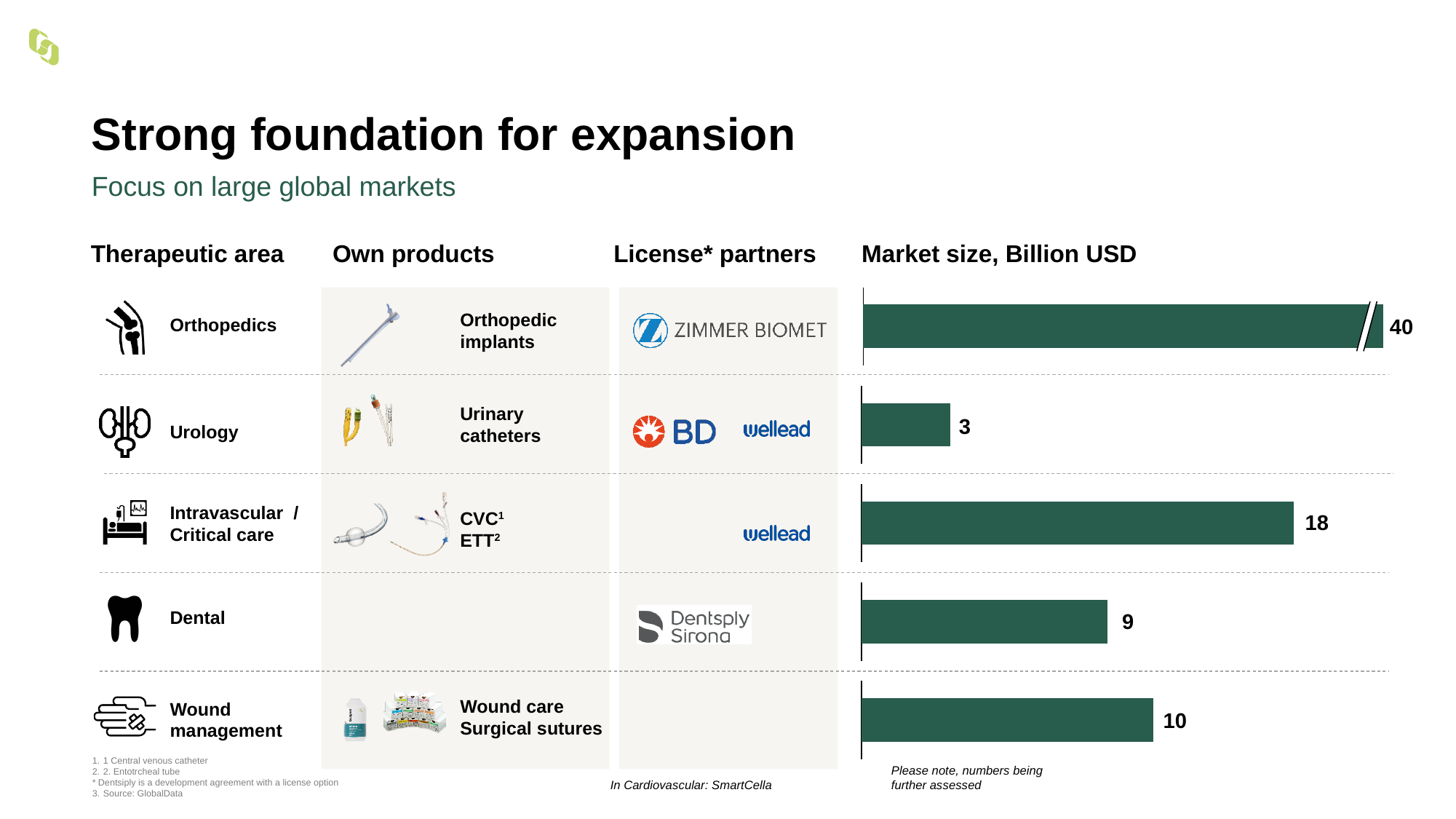
What is the difference in market size between Orthopedics and Intravascular / Critical care? 22 Which therapeutic area has the largest market size? Orthopedics What is the market size in billion USD for Wound management? 10 What is the market size in billion USD for Orthopedics? 40 Which therapeutic area has the smallest market size? Urology How many therapeutic areas are shown in the market size chart? 5 Which has a larger market size, Dental or Wound management? Wound management What is the market size in billion USD for Urology? 3 What unit is the market size chart measured in? Billion USD What is the market size in billion USD for Intravascular / Critical care? 18 What is the market size in billion USD for Dental? 9 What kind of chart is used to show market size? Bar chart